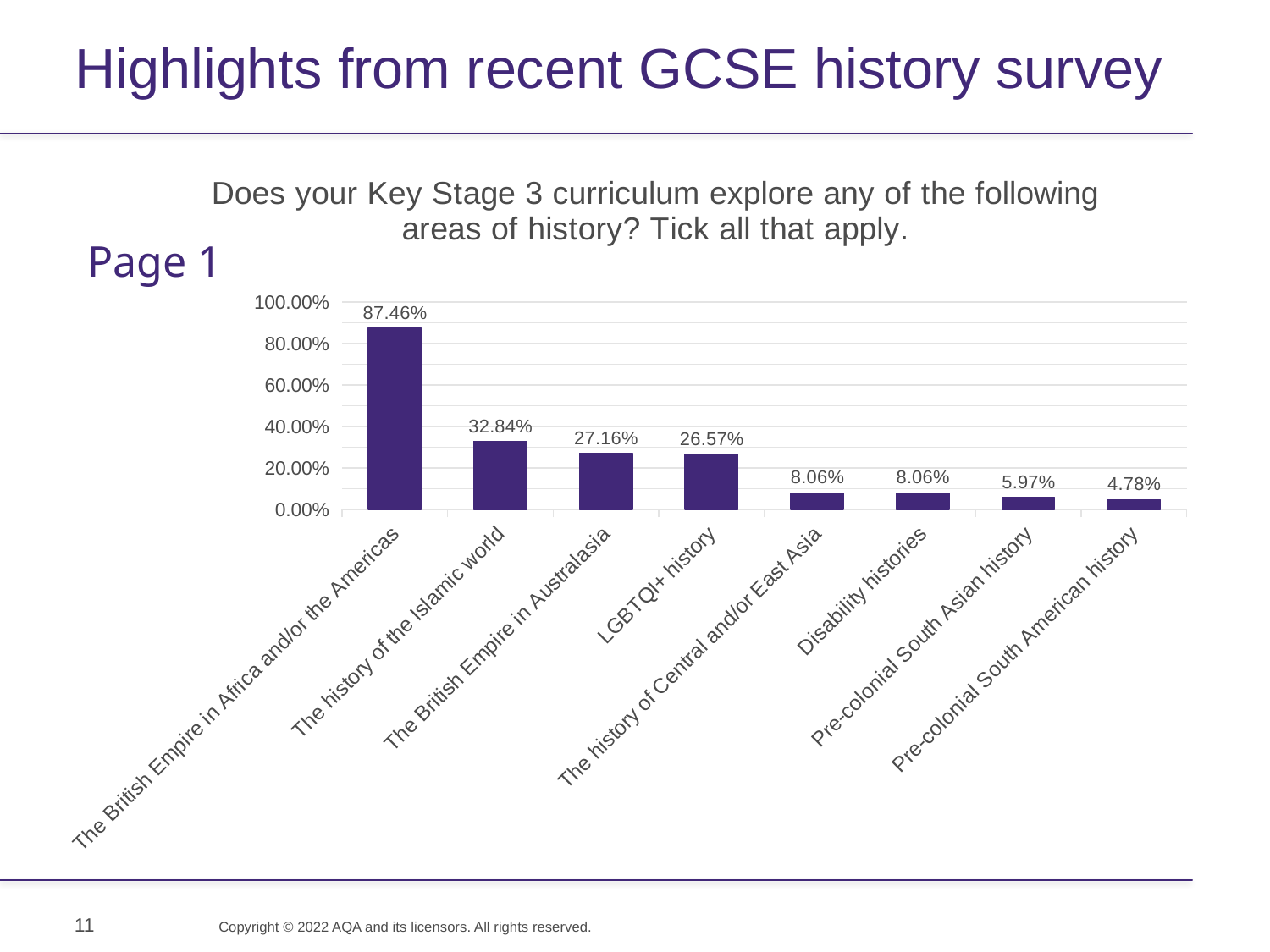
Which is larger, the value for Disability histories or the value for Pre-colonial South Asian history? Disability histories How many areas of history are shown on the chart? 8 Do the values rise or fall from left to right across the chart? fall What is the difference between the percentages for The history of the Islamic world and The British Empire in Australasia? 5.68% Is the value for The history of the Islamic world greater or less than 40.00%? less What kind of chart is shown on the slide? bar chart What percentage is shown for The British Empire in Africa and/or the Americas? 87.46% What percentage is shown for Pre-colonial South Asian history? 5.97% Which area of history has the highest percentage? The British Empire in Africa and/or the Americas What is the difference between the percentages for The history of Central and/or East Asia and Pre-colonial South American history? 3.28% What percentage is shown for LGBTQI+ history? 26.57% Which area of history has the lowest percentage? Pre-colonial South American history